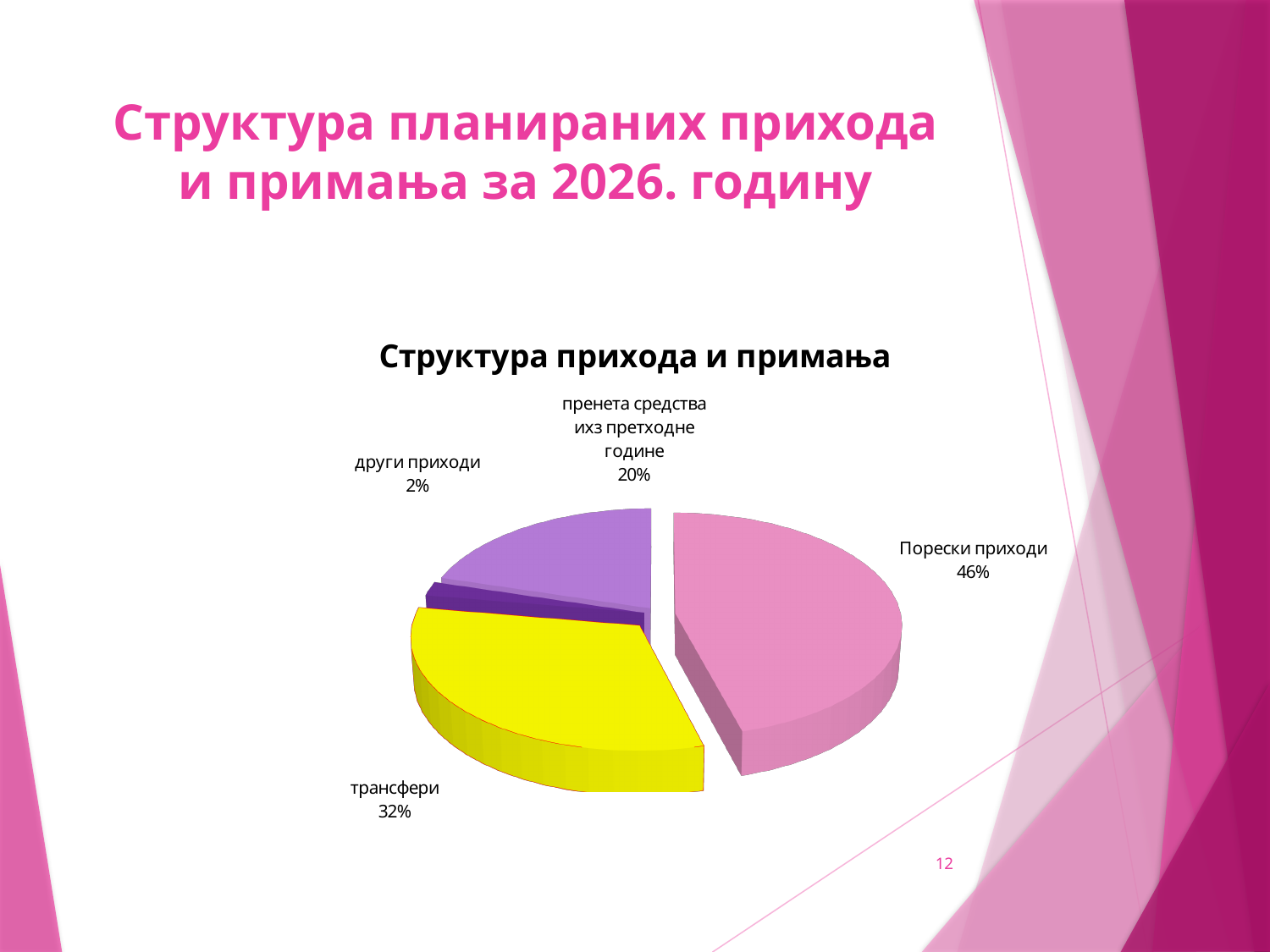
What kind of chart is shown on the slide? pie chart What is the value shown for други приходи? 2% What is the difference in percentage points between Порески приходи and трансфери? 14 What colour is the slice for трансфери? yellow What share of the pie does Порески приходи have? 46% Which category has the smallest slice of the pie? други приходи Which is larger, трансфери or пренета средства ихз претходне године? трансфери How many slices does the pie chart have? 4 Which category has the largest slice of the pie? Порески приходи What is the value shown for пренета средства ихз претходне године? 20% What is the value shown for трансфери? 32% What is the title of the chart? Структура прихода и примања